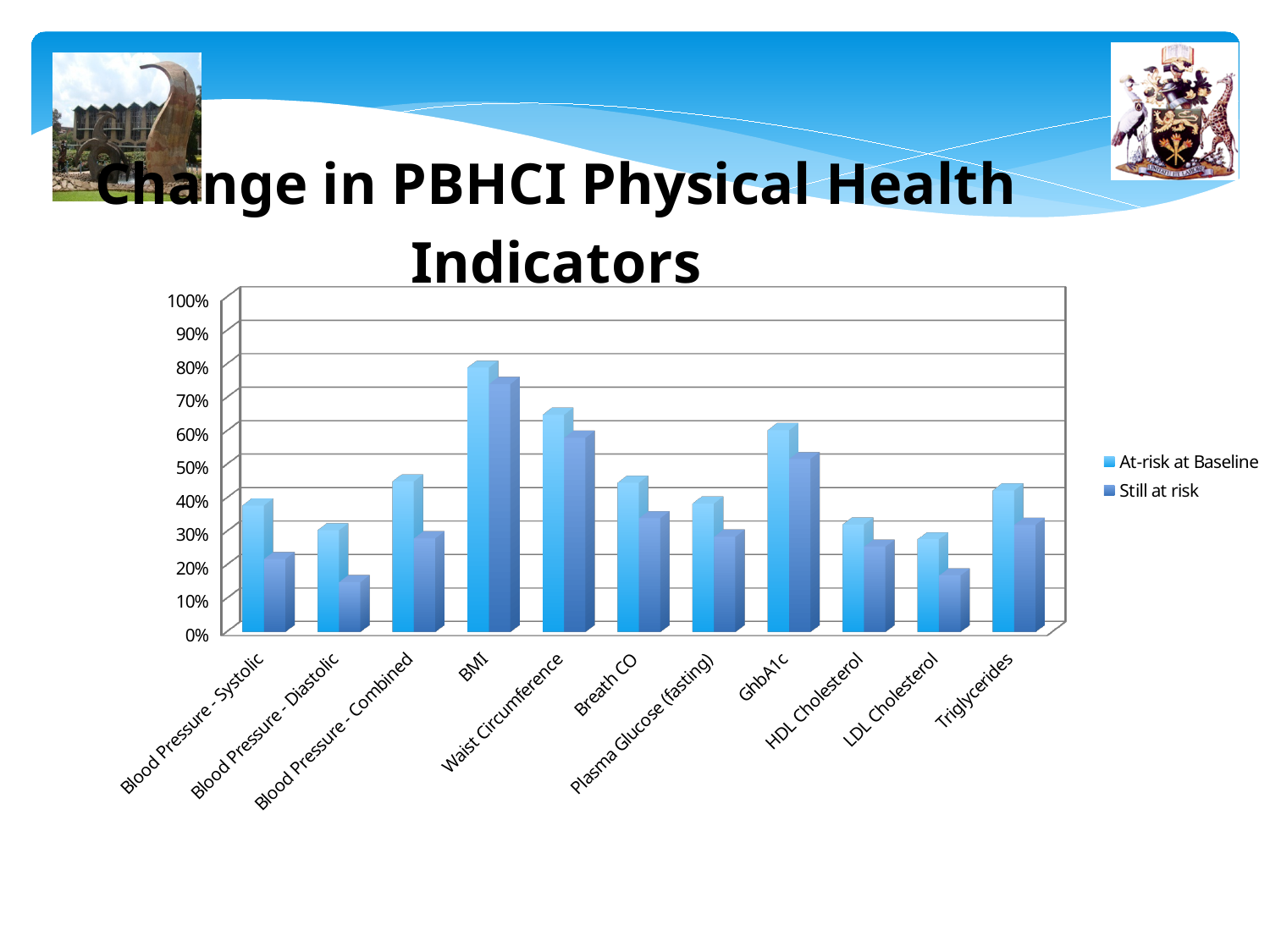
How many series does the legend list? 2 Which category has the highest Still at risk value? BMI Is the Still at risk value for Blood Pressure - Diastolic greater or less than 20%? less Is the Still at risk value for Waist Circumference greater or less than 50%? greater Is the At-risk at Baseline value for GhbA1c greater or less than 50%? greater Which is larger: the At-risk at Baseline value for Breath CO or for HDL Cholesterol? Breath CO What are the two series named in the legend? At-risk at Baseline and Still at risk What kind of chart is shown on the slide? bar chart For Blood Pressure - Systolic, which series has the larger value: At-risk at Baseline or Still at risk? At-risk at Baseline Which category has the highest At-risk at Baseline value? BMI How many categories are shown along the x axis of the chart? 11